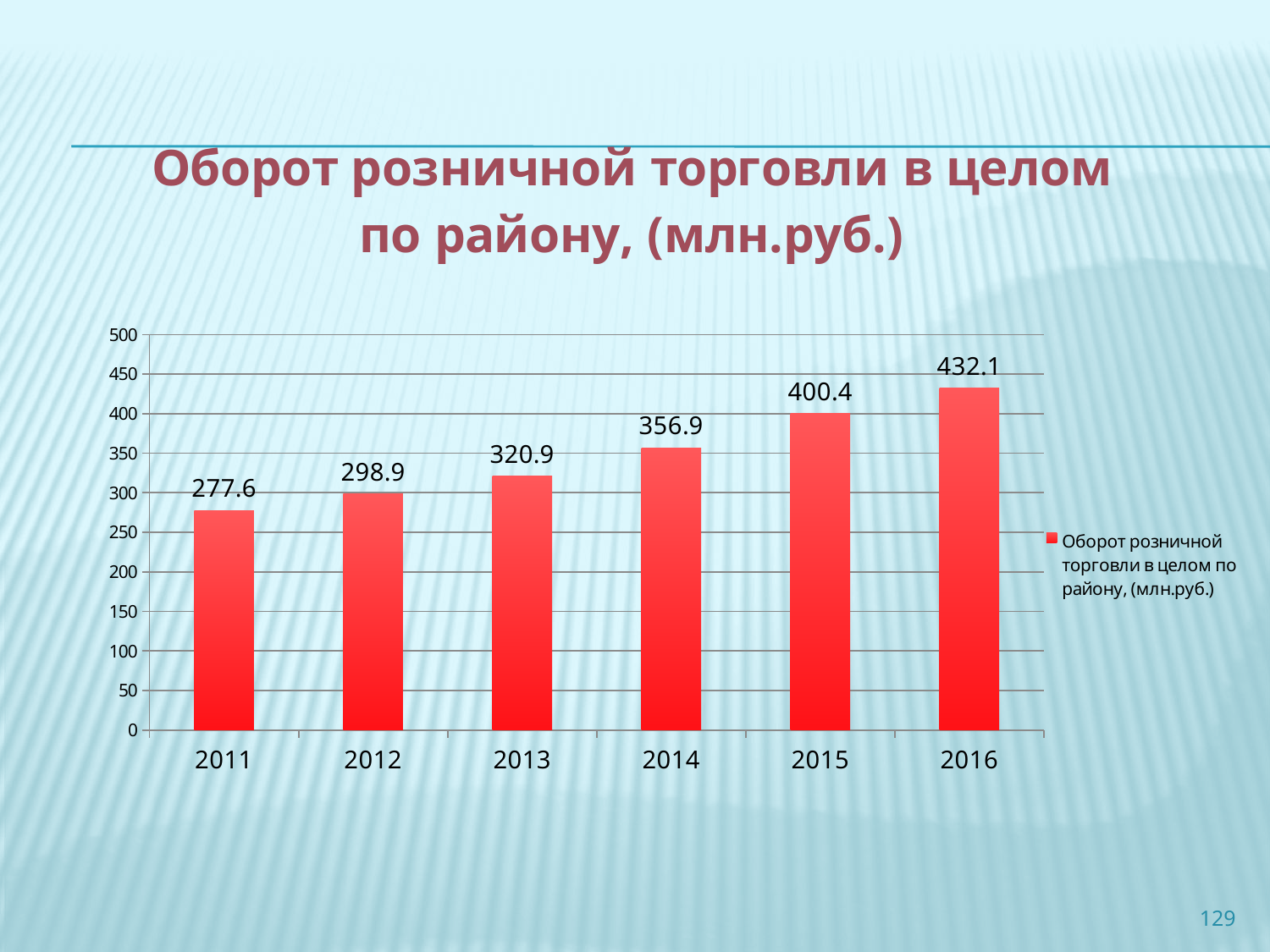
Do the values rise or fall from 2011 to 2016? rise Which year has the lowest retail trade turnover? 2011 What is the difference between the values for 2016 and 2015? 31.7 What is the value shown for 2016? 432.1 What is the difference between the values for 2013 and 2012? 22.0 How many years are shown on the x axis? 6 What is the value shown for 2011? 277.6 What kind of chart is shown on the slide? bar chart Is the value for 2015 greater or less than 350? greater Which year has the highest retail trade turnover? 2016 What is the retail trade turnover value for 2014? 356.9 Which is larger, the value for 2013 or the value for 2014? 2014